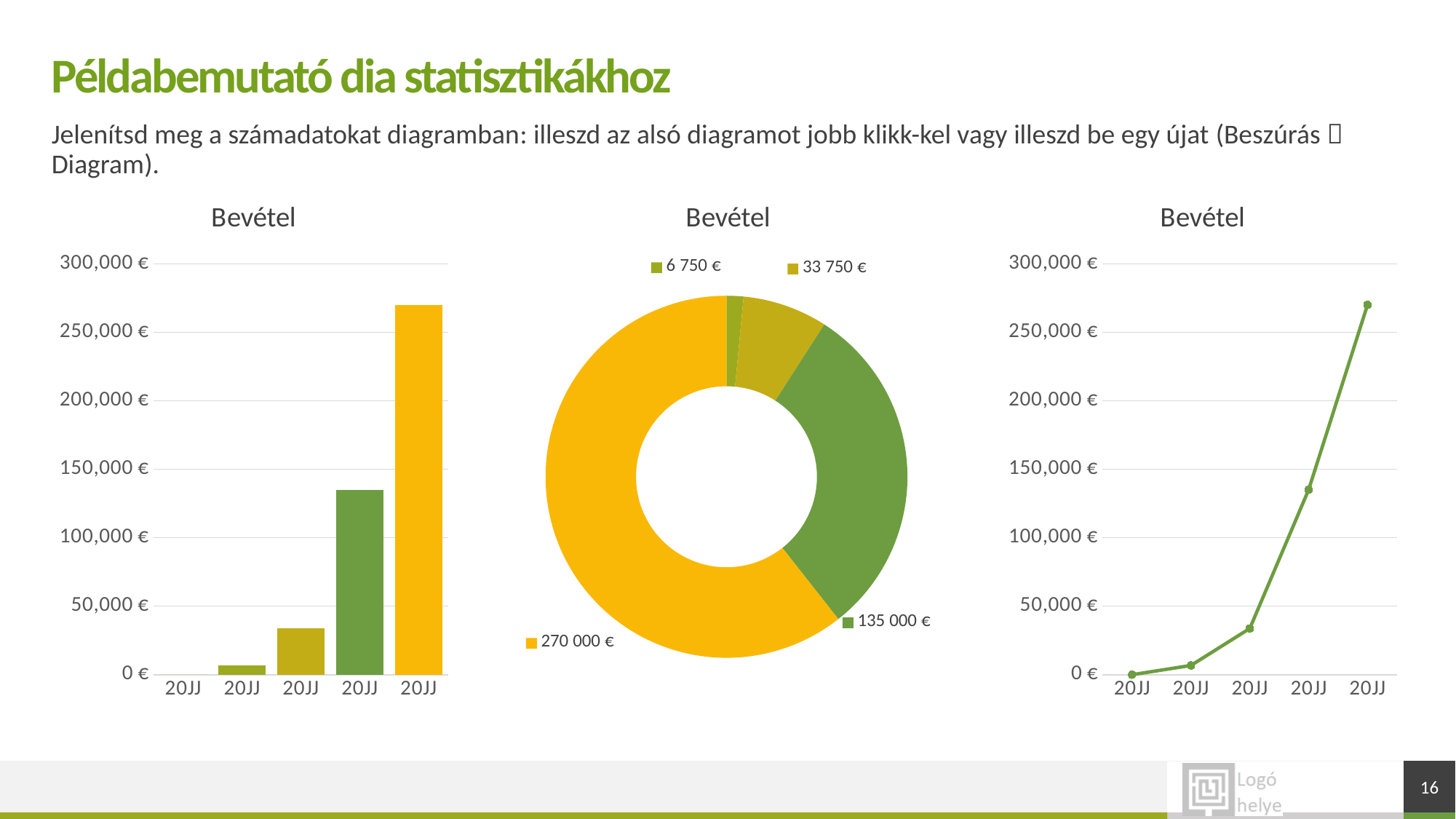
What title is shown above each of the three charts? Bevétel What kind of chart is the chart in the middle of the slide? doughnut chart In the line chart on the right, do the values rise or fall from left to right along the x axis? rise In the doughnut chart in the middle, what is the difference between the 270 000 € slice and the 135 000 € slice? 135 000 € What kind of chart is the chart on the right of the slide? line chart In the bar chart on the left, how many bars are plotted? 5 In the bar chart on the left, is the value of the fourth bar from the left greater or less than 150,000 €? less In the doughnut chart in the middle, what is the value of the largest slice? 270 000 € In the bar chart on the left, is the value of the rightmost bar greater or less than 250,000 €? greater In the doughnut chart in the middle, what is the value of the smallest slice? 6 750 € In the doughnut chart in the middle, how many slices are there? 4 What kind of chart is the chart on the left of the slide? bar chart